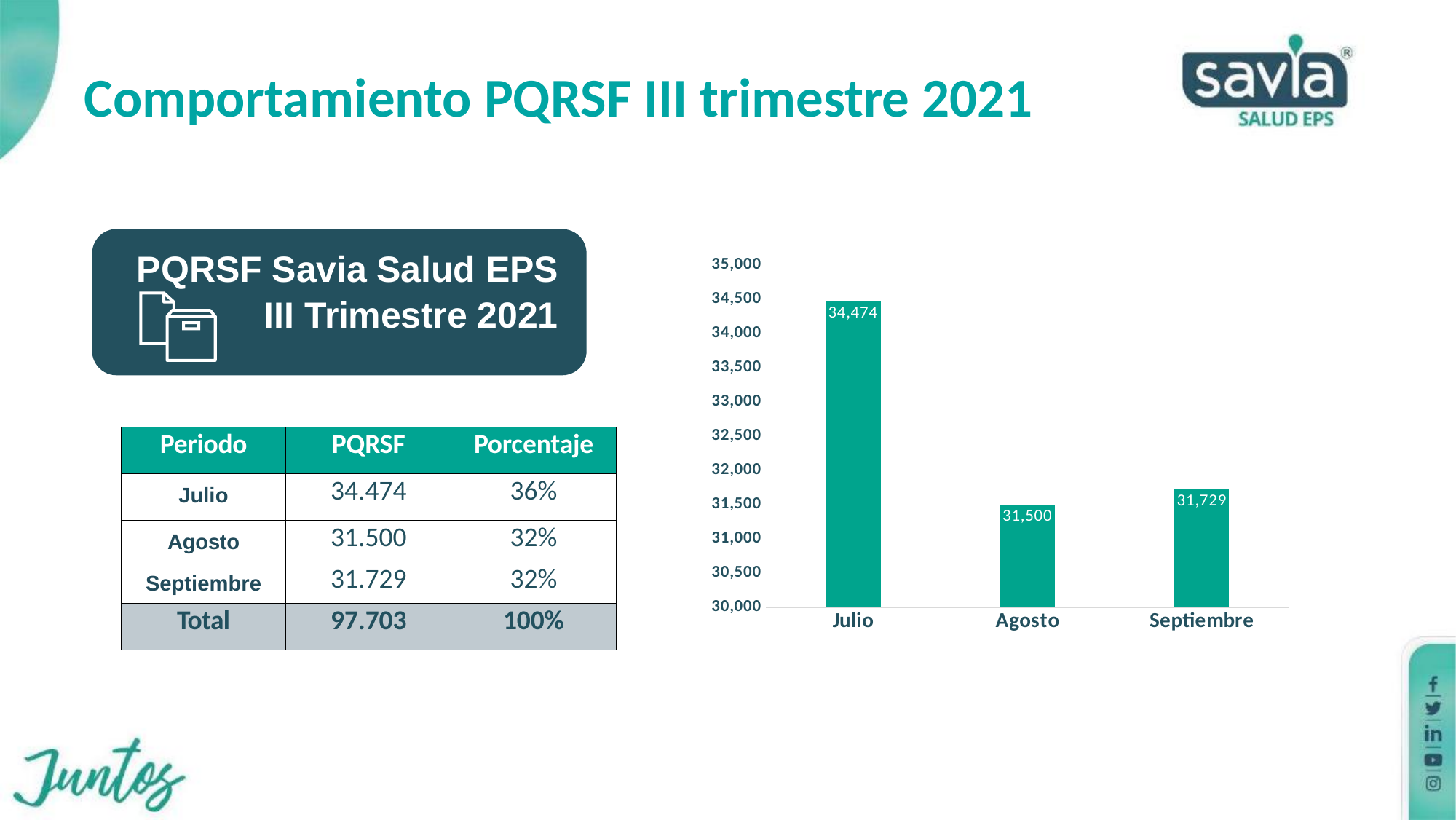
What is the highest value shown on the y axis of the bar chart? 35,000 What is the difference between the values for Julio and Agosto in the bar chart? 2,974 Is the value for Julio in the bar chart greater or less than 34,000? greater What is the value for Agosto in the bar chart? 31,500 Which month has the highest value in the bar chart? Julio Which month has the lowest value in the bar chart? Agosto What is the value for Septiembre in the bar chart? 31,729 Which is larger in the bar chart, the value for Julio or the value for Septiembre? Julio How many months are shown on the x axis of the bar chart? 3 What kind of chart is shown on the slide? bar chart What is the value for Julio in the bar chart? 34,474 What is the difference between the values for Septiembre and Agosto in the bar chart? 229